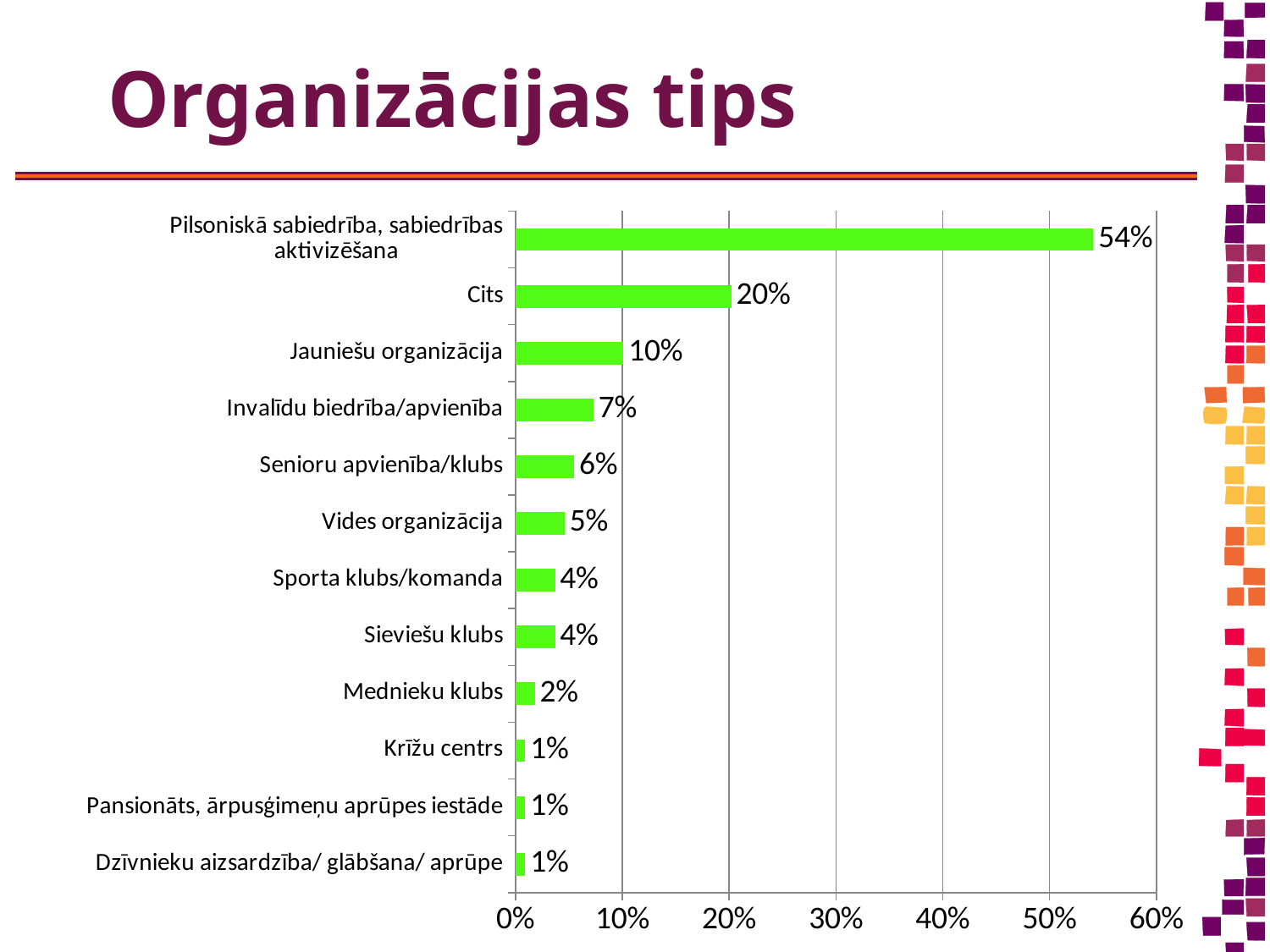
How many categories are shown in the chart? 12 Is the value for Pilsoniskā sabiedrība, sabiedrības aktivizēšana greater or less than 50%? greater Which category has the highest value? Pilsoniskā sabiedrība, sabiedrības aktivizēšana What is the value for Senioru apvienība/klubs? 6% What is the difference between the values for Pilsoniskā sabiedrība, sabiedrības aktivizēšana and Cits? 34% What is the value for Cits? 20% Which is larger, the value for Jauniešu organizācija or the value for Invalīdu biedrība/apvienība? Jauniešu organizācija What kind of chart is shown on the slide? bar chart What is the value for Jauniešu organizācija? 10% What is the difference between the values for Invalīdu biedrība/apvienība and Vides organizācija? 2% What is the value for Mednieku klubs? 2% What is the title of the slide? Organizācijas tips